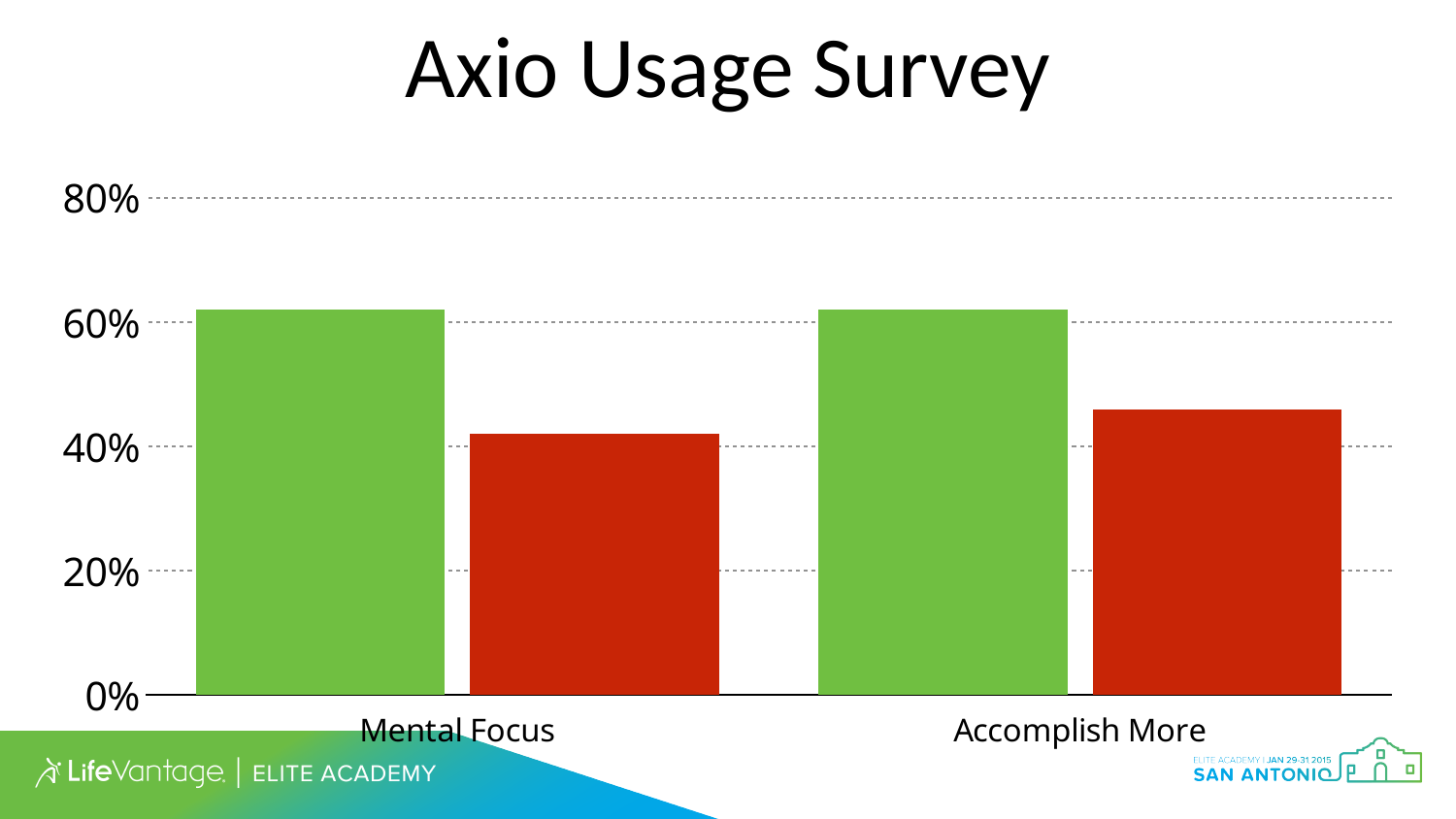
How many bars are plotted in the chart? 4 What is the title of the chart? Axio Usage Survey What kind of chart is shown on the slide? bar chart How many categories are shown on the x axis? 2 Is the red bar for Mental Focus greater or less than 60%? less What is the highest value shown on the y axis? 80% Is the red bar for Mental Focus greater or less than 20%? greater Is the red bar for Accomplish More greater or less than 40%? greater For Mental Focus, which bar is taller, the green one or the red one? the green one Which category has the taller red bar, Mental Focus or Accomplish More? Accomplish More